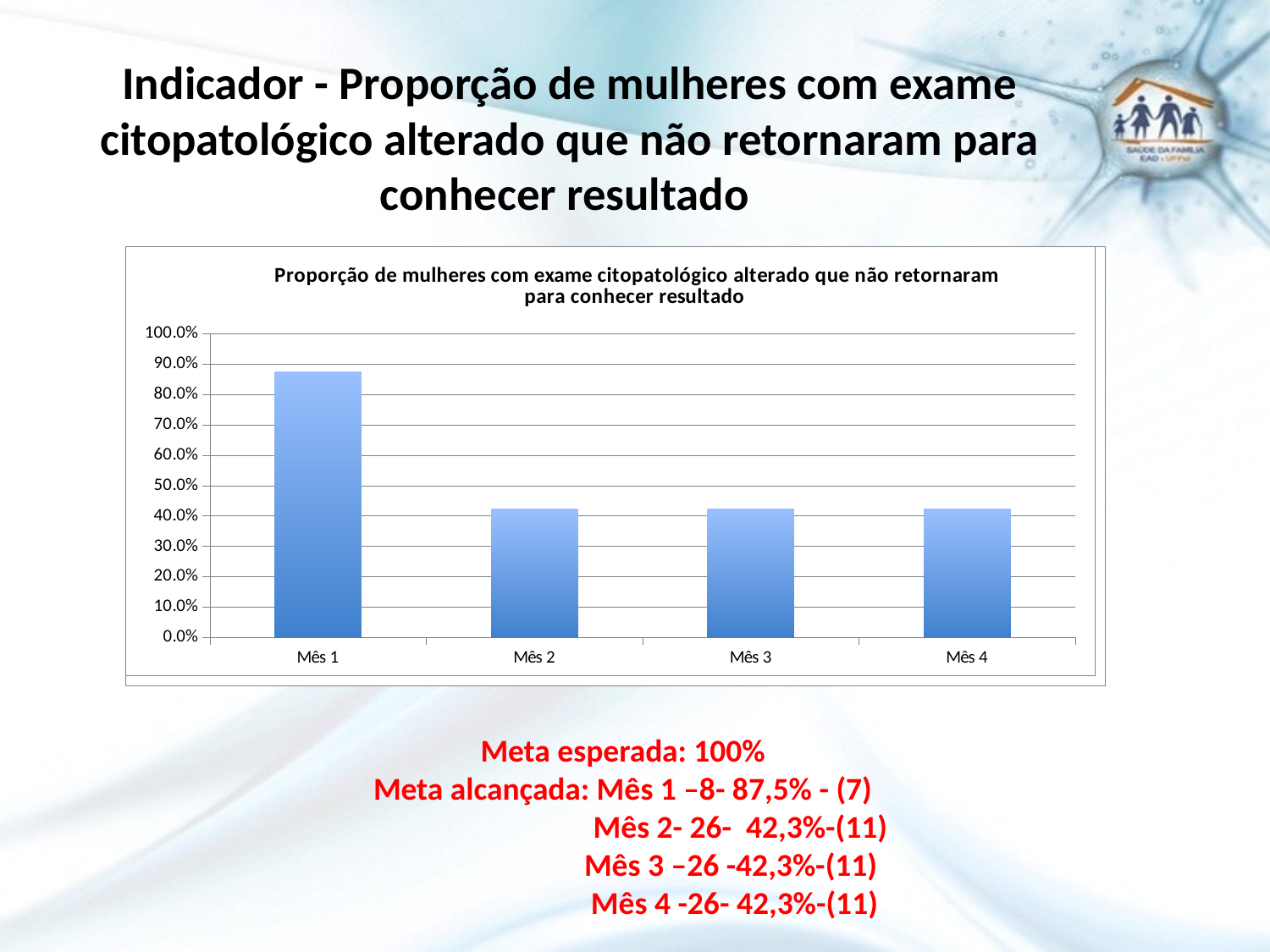
Is the value for Mês 2 greater or less than 50.0%? less What is the title of the chart? Proporção de mulheres com exame citopatológico alterado que não retornaram para conhecer resultado How many months (categories) are plotted on the x axis of the chart? 4 Which month has the highest bar in the chart? Mês 1 What kind of chart is shown on the slide? bar chart What is the highest tick value shown on the y axis of the chart? 100.0% Do the values rise or fall from Mês 1 to Mês 2? fall Which is larger, the value for Mês 4 or the value for Mês 1? Mês 1 Which is larger, the value for Mês 1 or the value for Mês 3? Mês 1 Is the value for Mês 4 greater or less than 60.0%? less Is the value for Mês 3 greater or less than 30.0%? greater